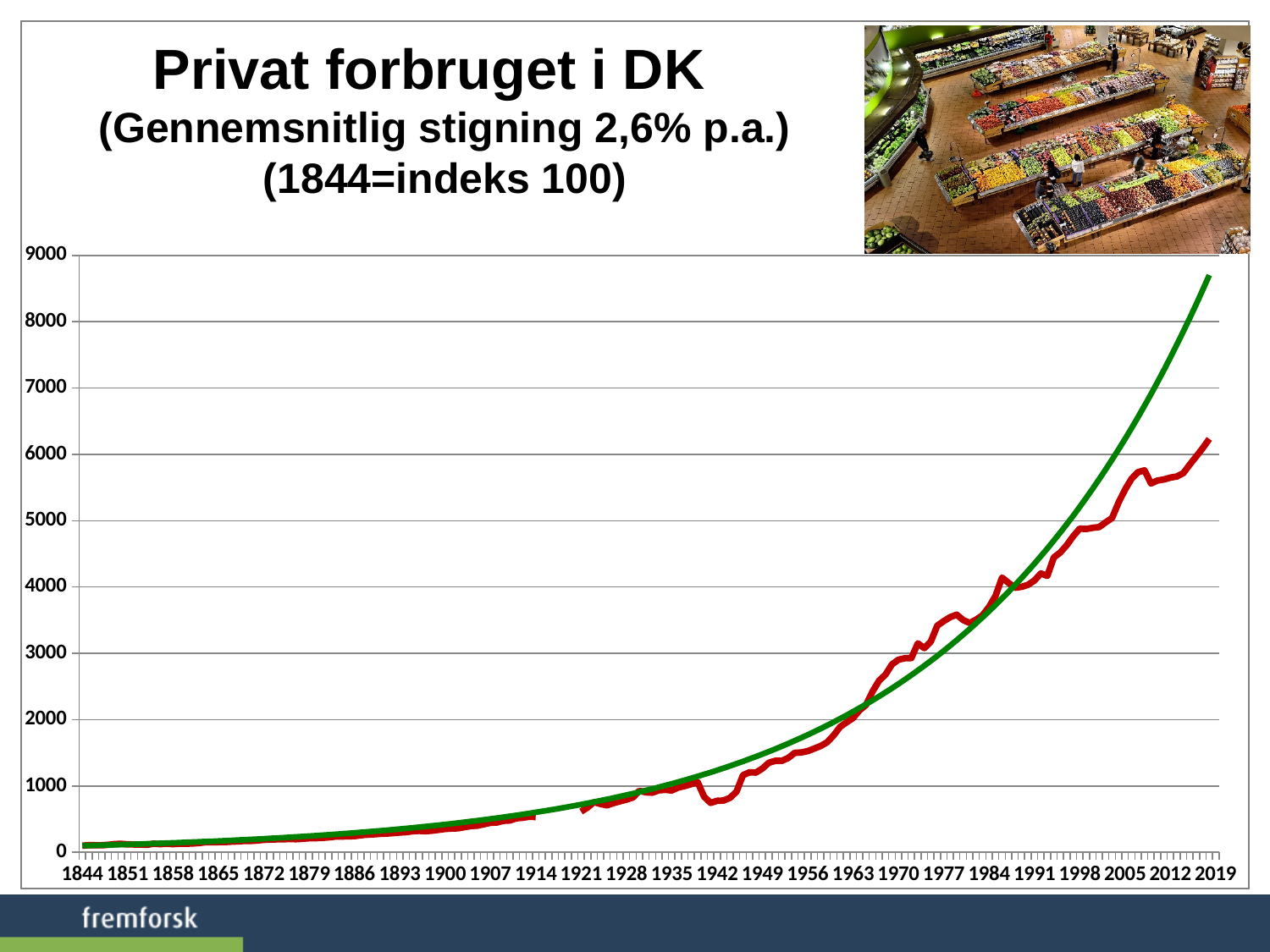
At 2019, which line has the higher value, the green line or the red line? green line Is the value of the green line at 2019 greater or less than 8000? greater How many lines are plotted on the chart? 2 Is the value of the red line at 2019 greater or less than 5000? greater Do the values of the red line generally rise or fall from 1844 to 2019? rise What is the title of the chart on the slide? Privat forbruget i DK What kind of chart is shown on the slide? line chart Is the value of the red line at 1977 greater or less than 3000? greater At 1970, which line has the higher value, the green line or the red line? red line What is the first year shown on the horizontal axis? 1844 What is the highest value shown on the vertical axis? 9000